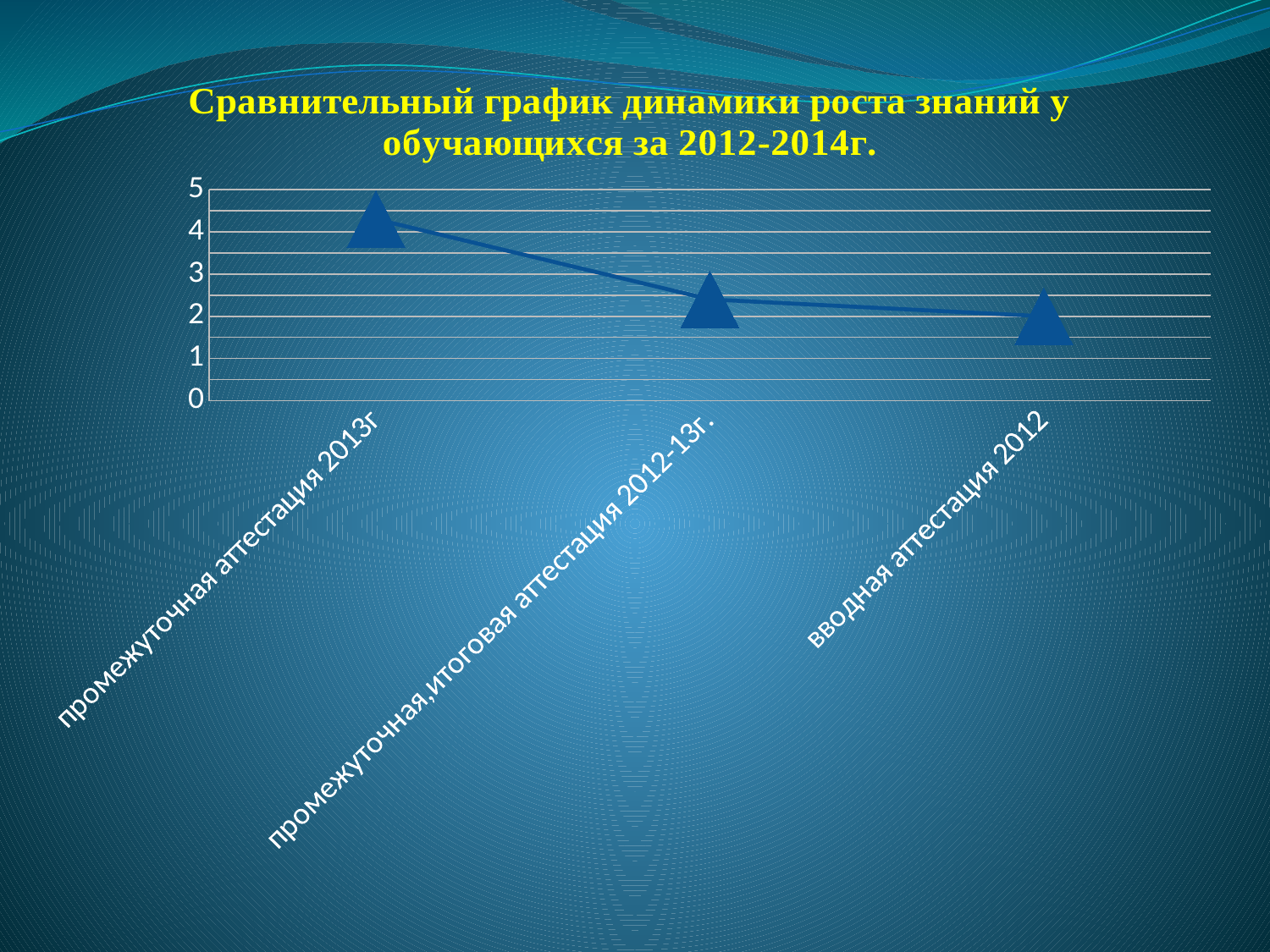
How many data points are plotted on the chart? 3 Is the value for вводная аттестация 2012 greater or less than 3? less What is the title of the chart on the slide? Сравнительный график динамики роста знаний у обучающихся за 2012-2014г. Is the value for промежуточная,итоговая аттестация 2012-13г. greater or less than 3? less What is the maximum value shown on the vertical axis? 5 Which is larger: the value for промежуточная аттестация 2013г or the value for вводная аттестация 2012? промежуточная аттестация 2013г Which category has the highest value on the chart? промежуточная аттестация 2013г Do the values rise or fall from left to right along the x axis? fall What kind of chart is shown on the slide? line chart Which category has the lowest value on the chart? вводная аттестация 2012 Is the value for промежуточная,итоговая аттестация 2012-13г. greater or less than 2? greater